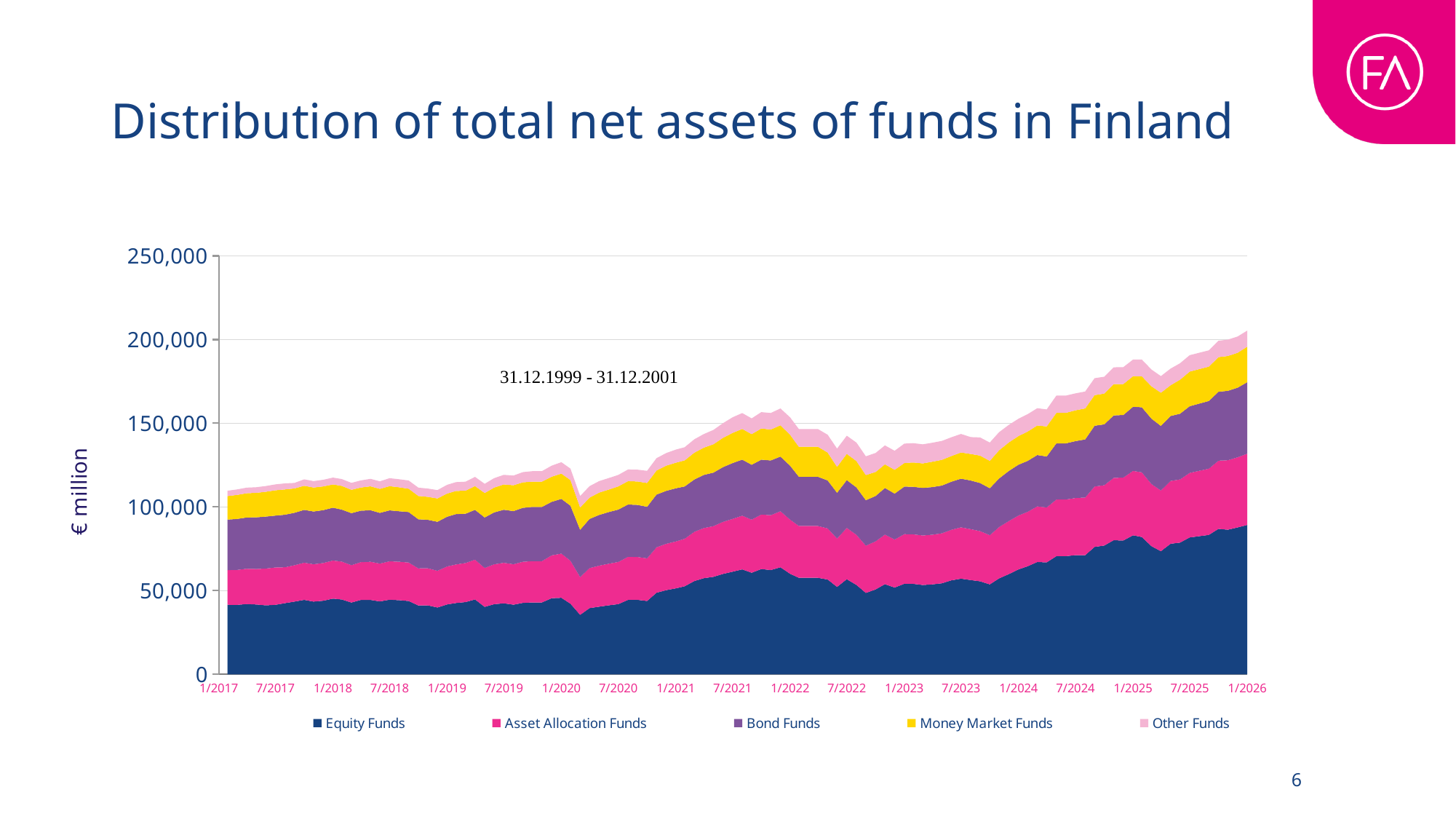
Does the total net assets of funds rise or fall from 1/2017 to 1/2026? Rise What is the label on the vertical axis? € million How many series does the legend list? 5 Is the total net assets of all funds at 1/2017 greater or less than 150,000? less What is the title of the chart? Distribution of total net assets of funds in Finland Is the value for Equity Funds at 1/2026 greater or less than 50,000? greater Is the total net assets of all funds at 1/2026 greater or less than 150,000? greater Which fund type has the largest net assets at 1/2026? Equity Funds How many date labels are shown along the x axis? 19 What kind of chart is shown on the slide? Stacked area chart Which is larger at 1/2026: Equity Funds or Other Funds? Equity Funds